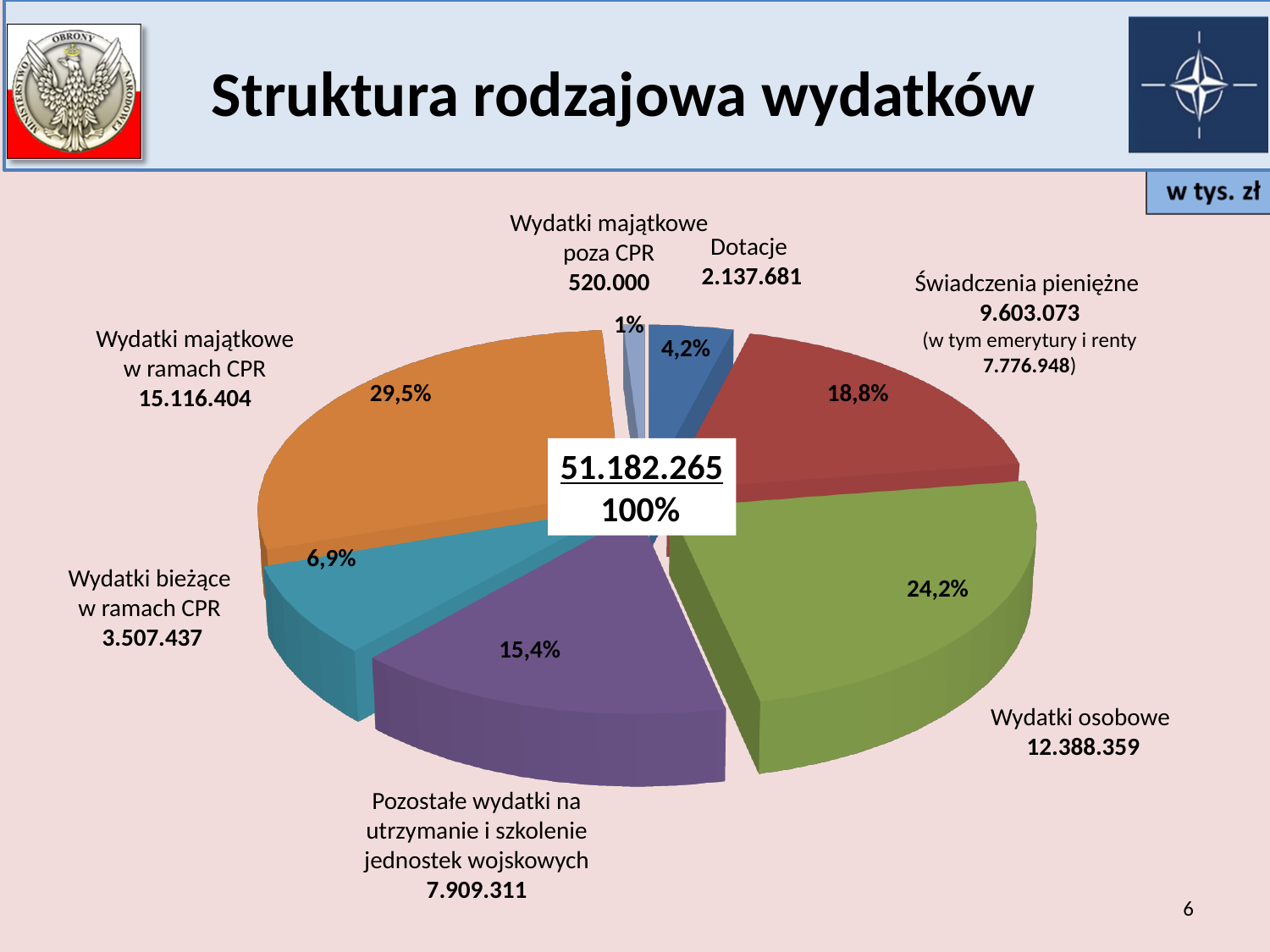
What is the total value shown in the centre of the pie chart? 51.182.265 What is the value shown for Wydatki bieżące w ramach CPR? 3.507.437 What is the value shown for Dotacje? 2.137.681 Which category has the smallest share of the pie? Wydatki majątkowe poza CPR Which category has the largest share of the pie? Wydatki majątkowe w ramach CPR What type of chart is shown on the slide? pie chart What unit is indicated in the box at the top right of the chart area? w tys. zł How many slices does the pie chart have? 7 What percentage share does Świadczenia pieniężne have? 18,8% Which is larger: Wydatki osobowe or Świadczenia pieniężne? Wydatki osobowe What is the value shown for Wydatki osobowe? 12.388.359 What percentage share does Wydatki majątkowe w ramach CPR have in the pie chart? 29,5%